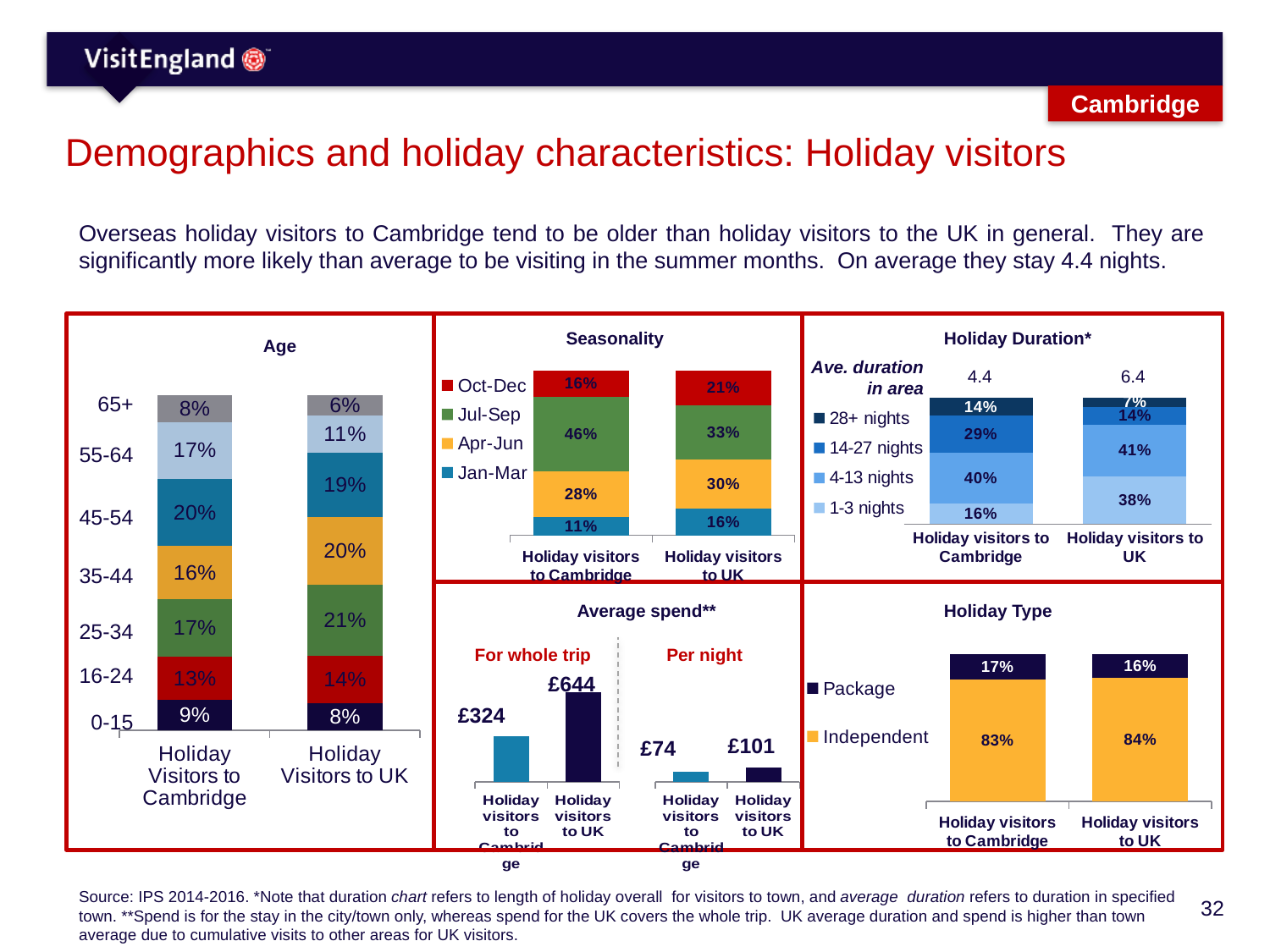
In the Average spend chart, what is the difference in per night spend between holiday visitors to UK and holiday visitors to Cambridge? £27 In the Holiday Duration chart, what percentage of holiday visitors to UK stay 1-3 nights? 38% How many series does the legend of the Seasonality chart list? 4 In the Seasonality chart, what percentage of holiday visitors to Cambridge visit in Jul-Sep? 46% In the Seasonality chart, what is the difference between the Jul-Sep share for holiday visitors to Cambridge and for holiday visitors to UK? 13 percentage points In the Average spend chart, what is the spend for the whole trip for holiday visitors to Cambridge? £324 In the Holiday Type chart, what percentage of holiday visitors to Cambridge are on a Package holiday? 17% In the Age chart, what percentage of holiday visitors to Cambridge are aged 45-54? 20% In the Age chart, which age group has the lowest share among holiday visitors to UK? 65+ In the Holiday Duration chart, what is the average duration in area for holiday visitors to Cambridge? 4.4 In the Age chart, what percentage of holiday visitors to UK are aged 25-34? 21% What kind of chart is the Holiday Type chart? Stacked bar chart